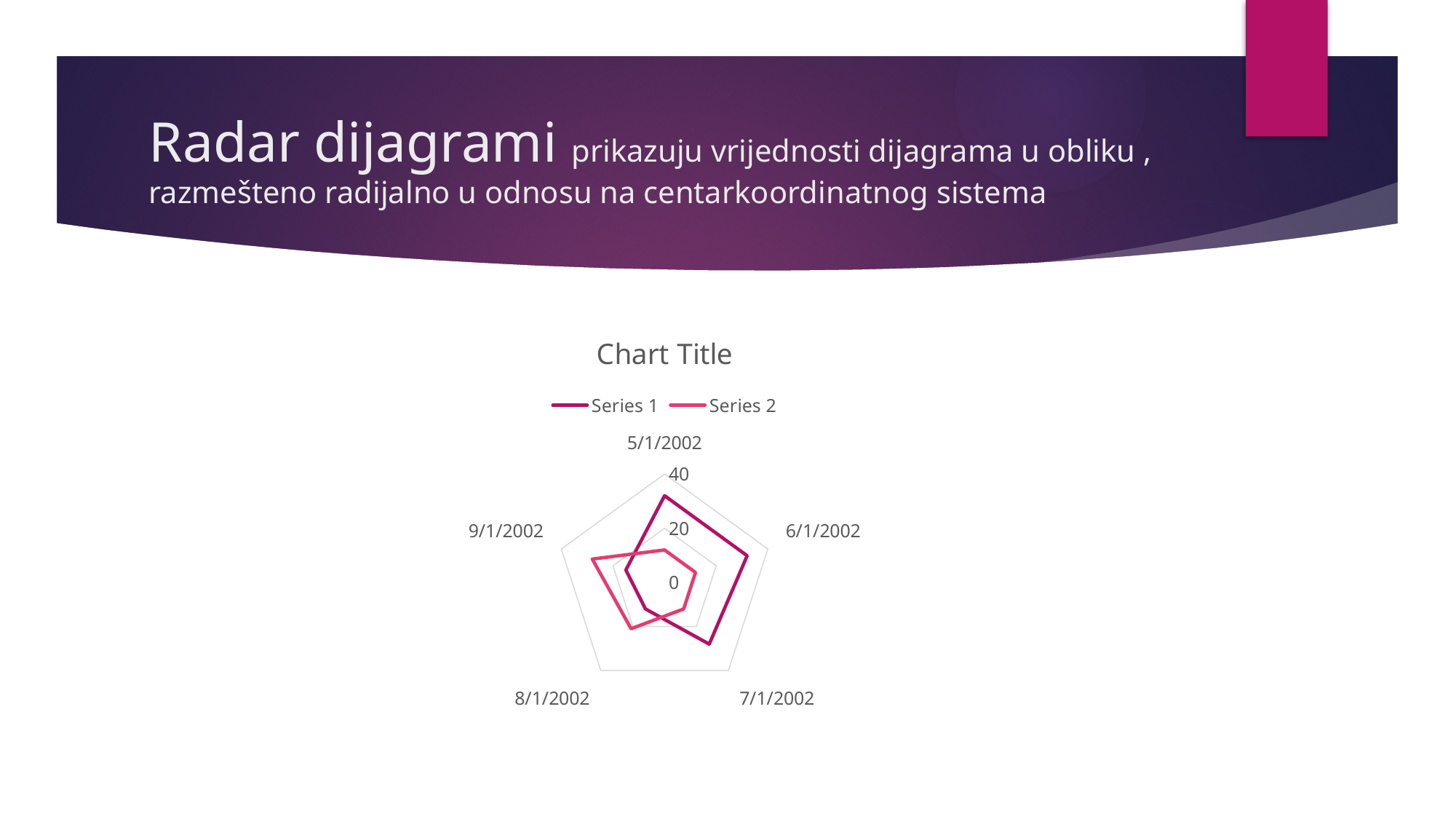
Is the value of Series 1 for 5/1/2002 greater or less than 20? greater Is the value of Series 2 for 9/1/2002 greater or less than 20? greater What are the names of the two series in the legend? Series 1 and Series 2 What is the title of the chart? Chart Title For 8/1/2002, which series has the larger value, Series 1 or Series 2? Series 2 How many series does the chart legend list? 2 For 5/1/2002, which series has the larger value, Series 1 or Series 2? Series 1 Is the value of Series 1 for 9/1/2002 greater or less than 20? less How many categories (dates) are plotted around the radar chart? 5 What kind of chart is shown on the slide? Radar chart